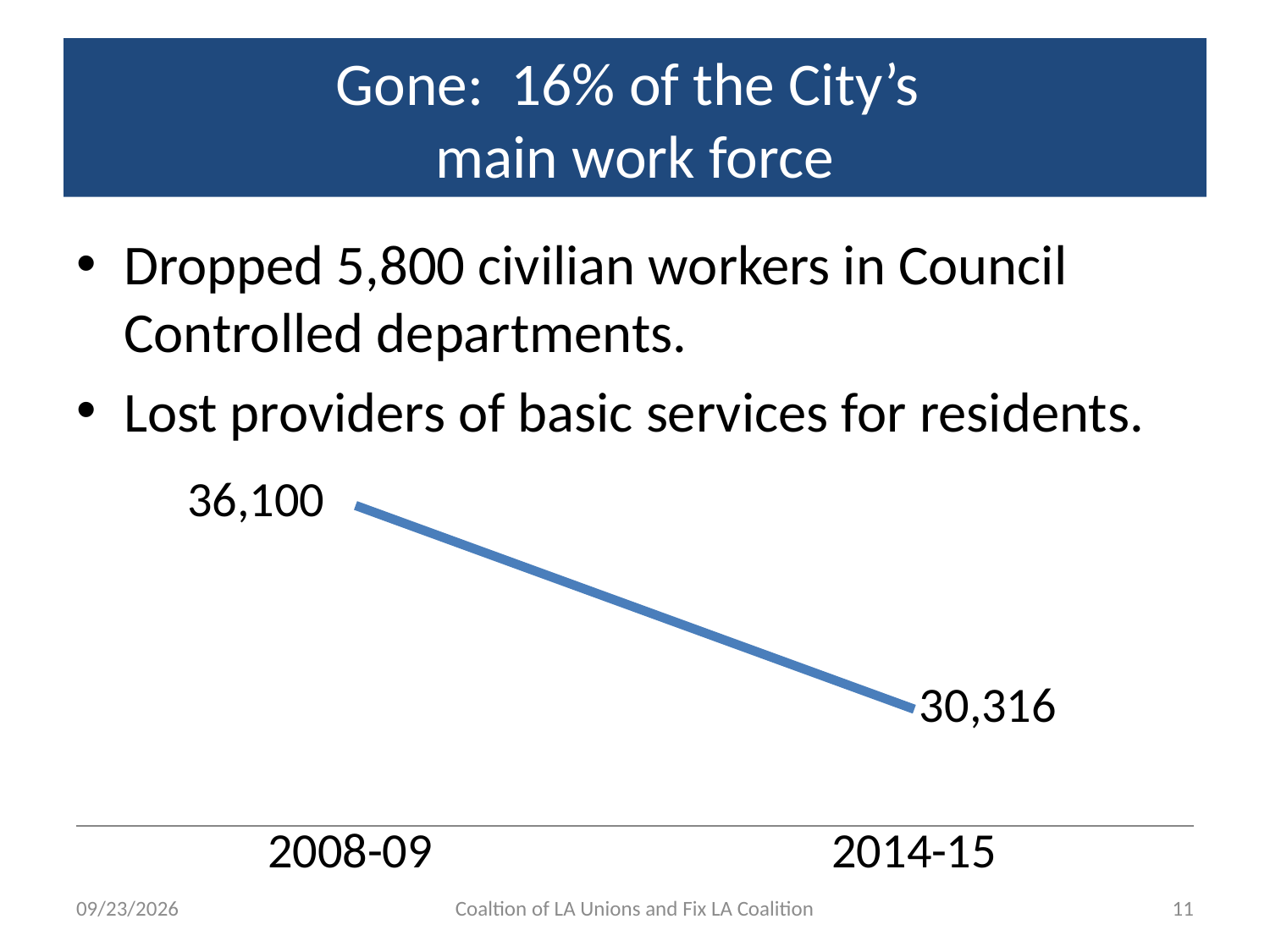
What is the title of the slide containing the chart? Gone: 16% of the City's main work force What is the value shown for 2008-09? 36,100 Which year has the highest value on the chart? 2008-09 Which year has the higher value, 2008-09 or 2014-15? 2008-09 Do the values rise or fall from 2008-09 to 2014-15? fall What colour is the line on the chart? blue What kind of chart is shown on the slide? line chart How many data points are plotted on the chart? 2 What is the value shown for 2014-15? 30,316 Which year has the lowest value on the chart? 2014-15 What is the difference between the 2008-09 value and the 2014-15 value? 5,784